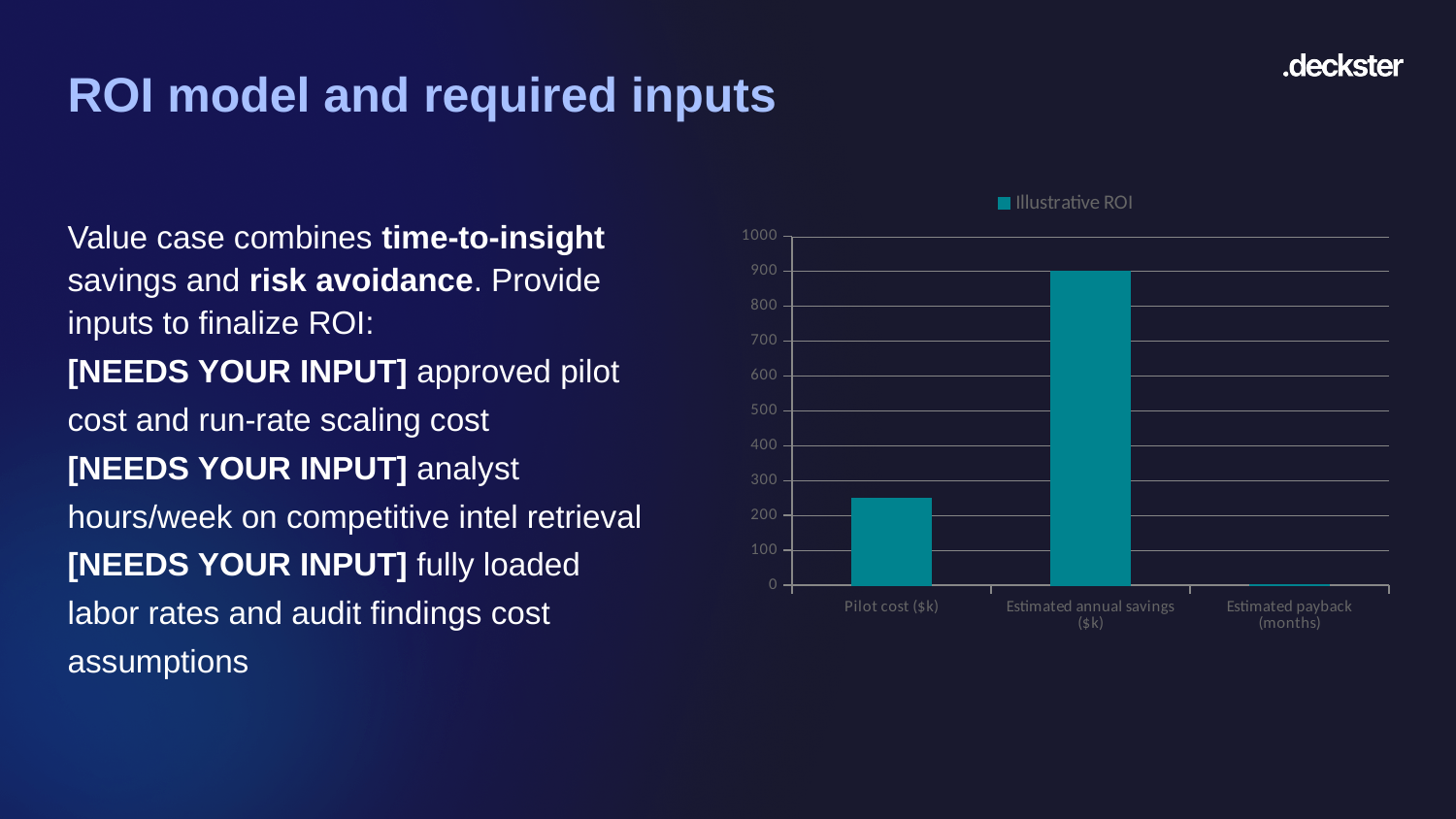
What kind of chart is shown on the slide? bar chart How many series does the chart legend list? 1 Is the value for Estimated annual savings ($k) greater or less than 800? greater What is the maximum value shown on the vertical axis? 1000 Which category has the highest bar? Estimated annual savings ($k) Is the value for Pilot cost ($k) greater or less than 200? greater What is the name of the series shown in the chart legend? Illustrative ROI How many categories are plotted on the chart? 3 Which is larger, the bar for Pilot cost ($k) or the bar for Estimated annual savings ($k)? Estimated annual savings ($k) Is the value for Estimated payback (months) greater or less than 100? less Which category has the lowest bar? Estimated payback (months)